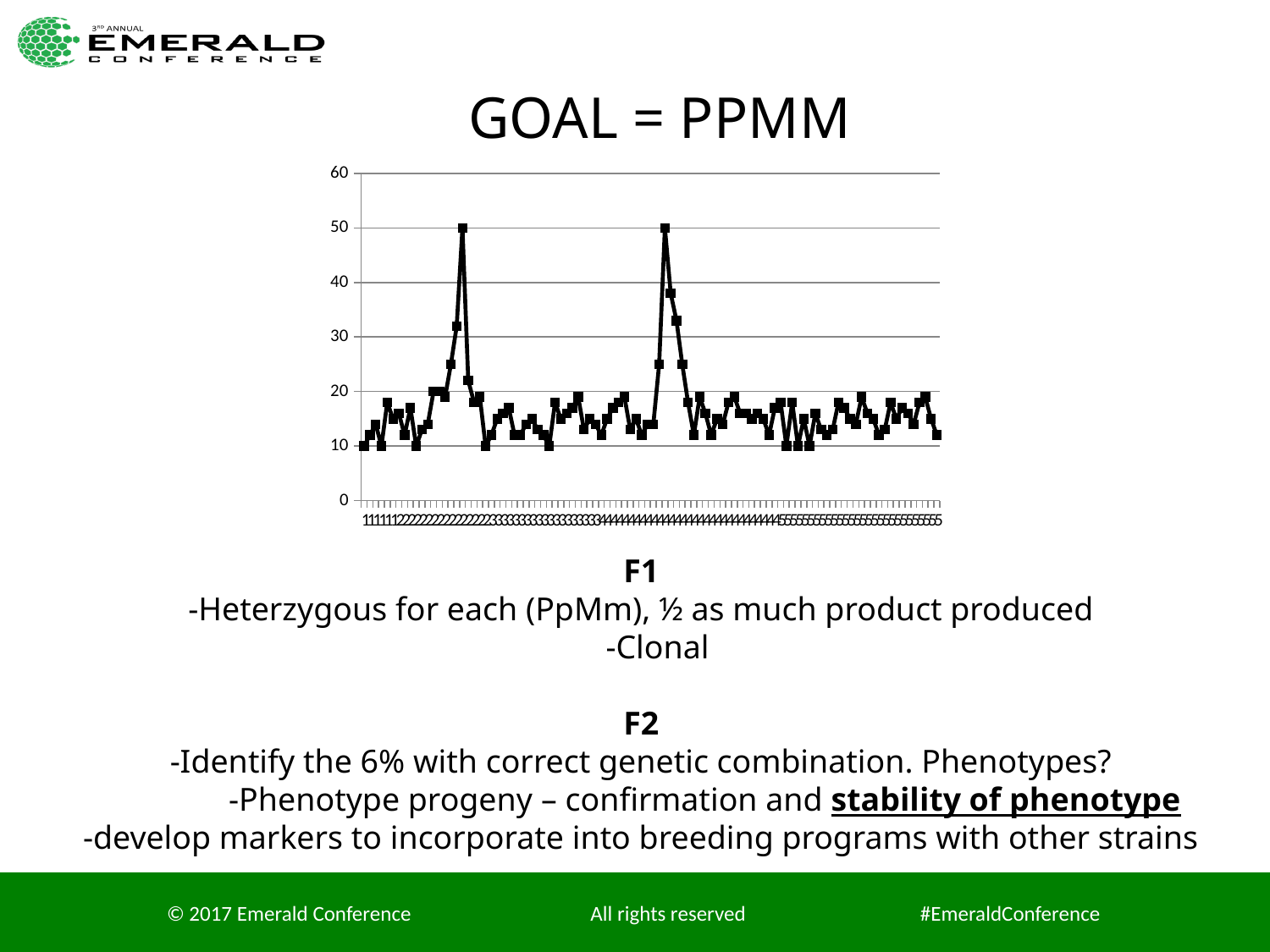
Is the highest value in the chart greater or less than 60? less What is the highest value reached by the line in the chart? 50 How many peaks in the chart reach the 50 gridline? 2 What is the lowest value the line drops to in the chart? 10 Is the highest value in the chart greater or less than 40? greater What kind of chart is shown on the slide? line chart Is the value at the first peak of the line greater or less than 30? greater How many data series are plotted in the chart? 1 What is the interval between tick marks on the chart's vertical axis? 10 What is the maximum value shown on the chart's vertical axis? 60